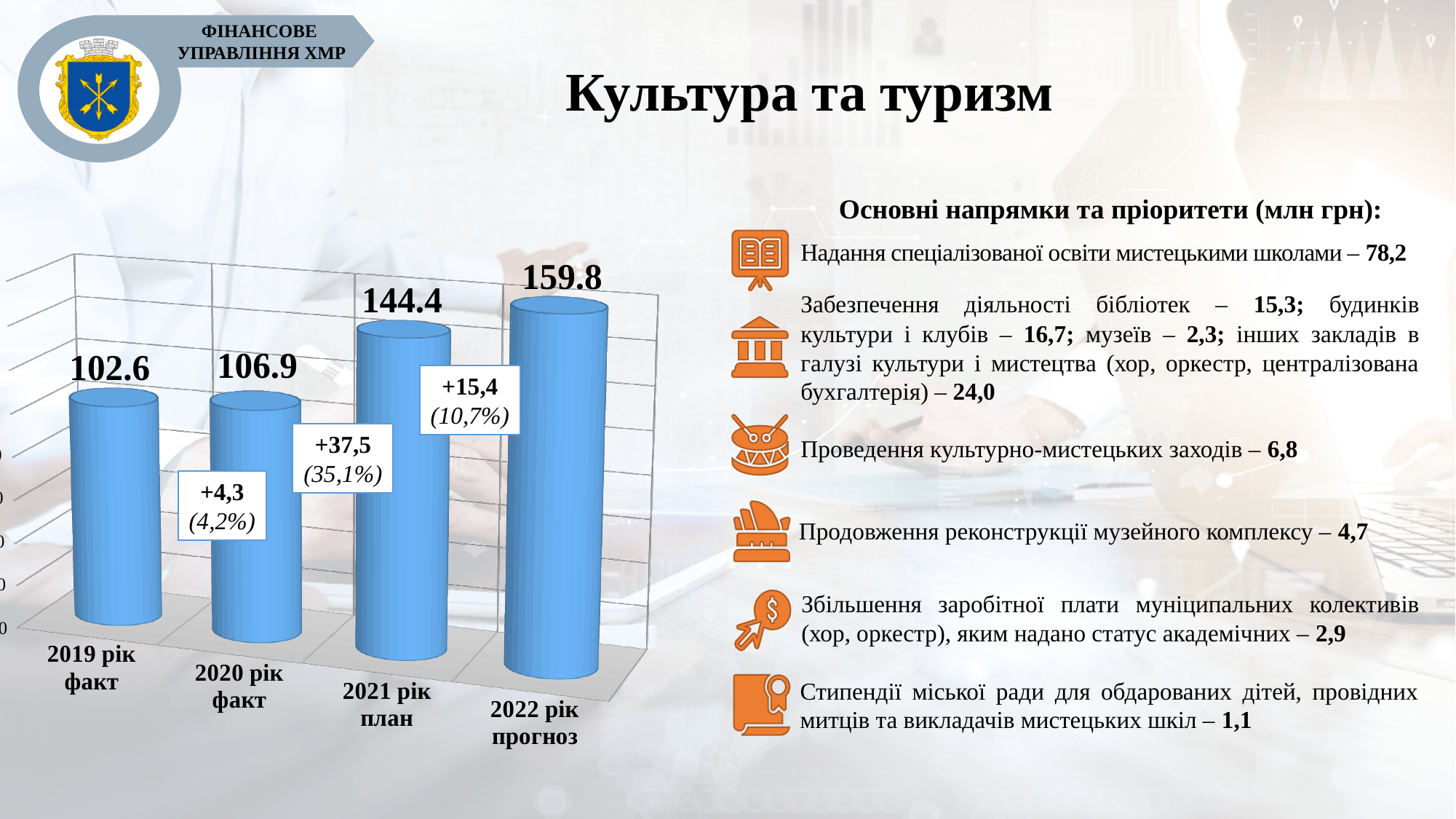
Which category has the lowest value? 2019 рік факт What is the value for 2022 рік прогноз? 159.8 Do the values rise or fall from 2019 рік факт to 2022 рік прогноз? rise What is the value for 2021 рік план? 144.4 What is the value for 2020 рік факт? 106.9 What is the difference between the values for 2022 рік прогноз and 2021 рік план? 15.4 What kind of chart is shown on the slide? bar chart How many categories are shown on the chart? 4 Which category has the highest value? 2022 рік прогноз Which is larger, the value for 2020 рік факт or the value for 2019 рік факт? 2020 рік факт What is the difference between the values for 2021 рік план and 2020 рік факт? 37.5 What is the value for 2019 рік факт? 102.6